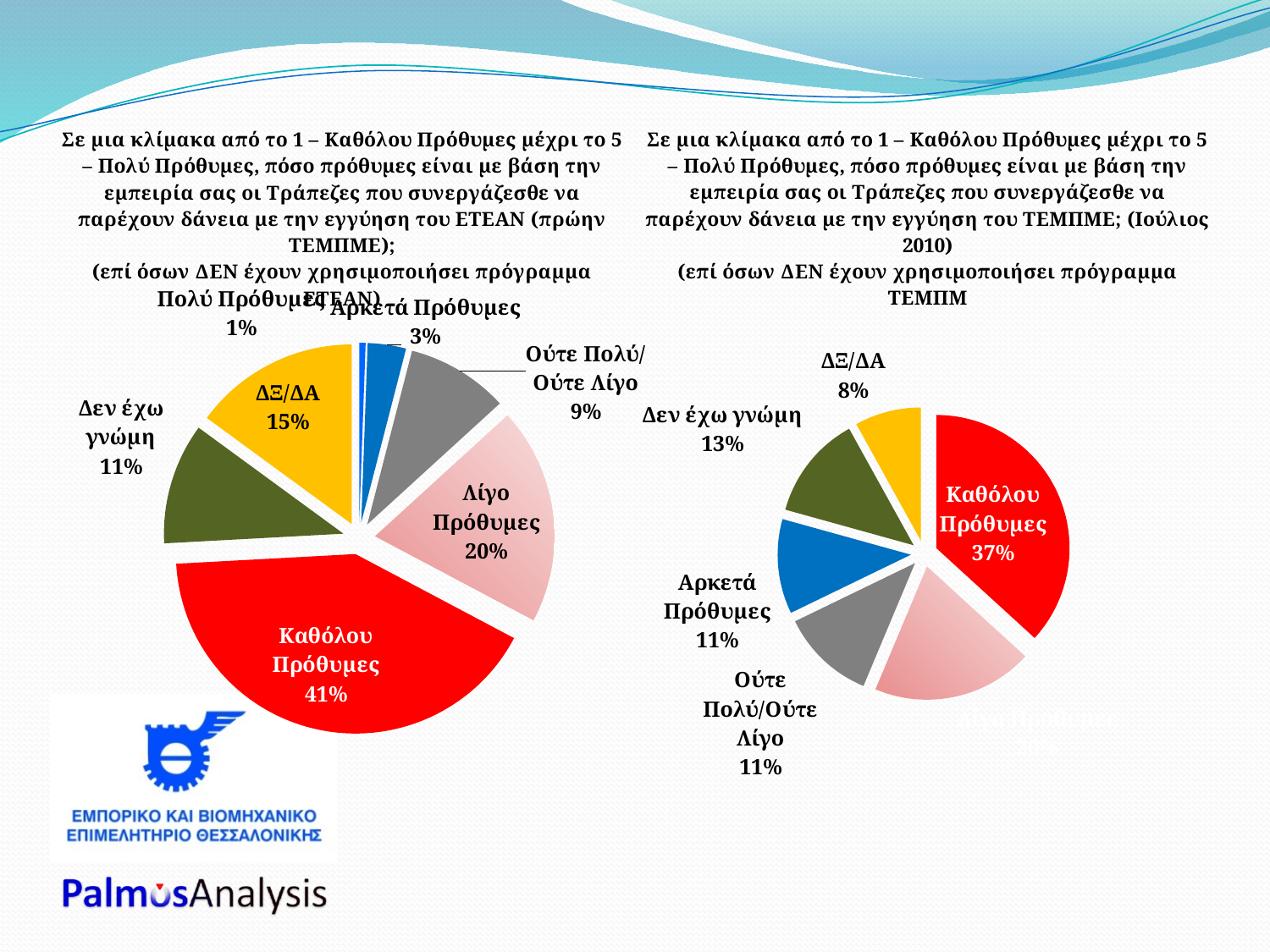
How many slices does the left pie chart (ETEAN) have? 7 In the right pie chart (ΤΕΜΠΜΕ), what is the share for Δεν έχω γνώμη? 13% What is the difference between the Καθόλου Πρόθυμες share in the left chart (ETEAN) and in the right chart (ΤΕΜΠΜΕ)? 4 percentage points In the left pie chart (ETEAN), which category has the largest slice? Καθόλου Πρόθυμες In the left pie chart (ETEAN), which category has the smallest slice? Πολύ Πρόθυμες What type of chart is used on this slide? Pie chart In the right pie chart (ΤΕΜΠΜΕ, Ιούλιος 2010), what percentage of respondents answered Καθόλου Πρόθυμες? 37% In the left pie chart (ETEAN), what is the share for ΔΞ/ΔΑ? 15% In the left pie chart (ETEAN), what is the combined share of Πολύ Πρόθυμες and Αρκετά Πρόθυμες? 4% In the left pie chart (ETEAN), what percentage of respondents answered Καθόλου Πρόθυμες? 41% In the right pie chart (ΤΕΜΠΜΕ), which category has the smallest labelled slice? ΔΞ/ΔΑ In the left pie chart (ETEAN), which is larger: Λίγο Πρόθυμες or Δεν έχω γνώμη? Λίγο Πρόθυμες